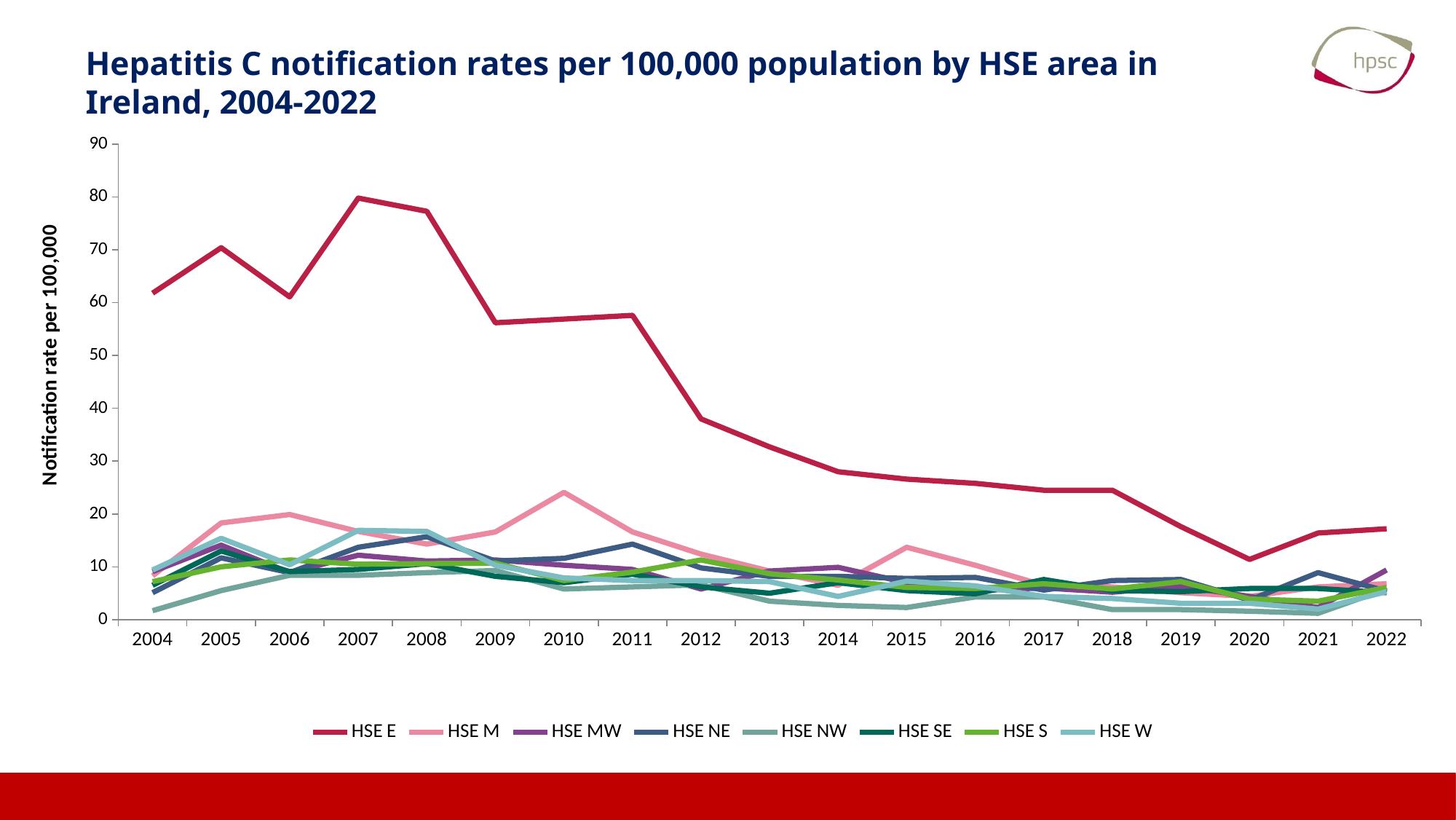
How many years are shown along the x axis? 19 Is the value for HSE M in 2010 greater or less than 20? greater Is the value for HSE E in 2007 greater or less than 70? greater What is the label on the y axis? Notification rate per 100,000 How many series does the legend list? 8 Which HSE area has the highest notification rate in 2007? HSE E Is the value for HSE E in 2020 greater or less than 20? less What kind of chart is shown on the slide? line chart In which year does the HSE E line reach its highest value? 2007 Does the HSE E line overall rise or fall from 2004 to 2022? fall Which is larger in 2010, the value for HSE E or the value for HSE M? HSE E Which HSE area has the lowest notification rate in 2004? HSE NW